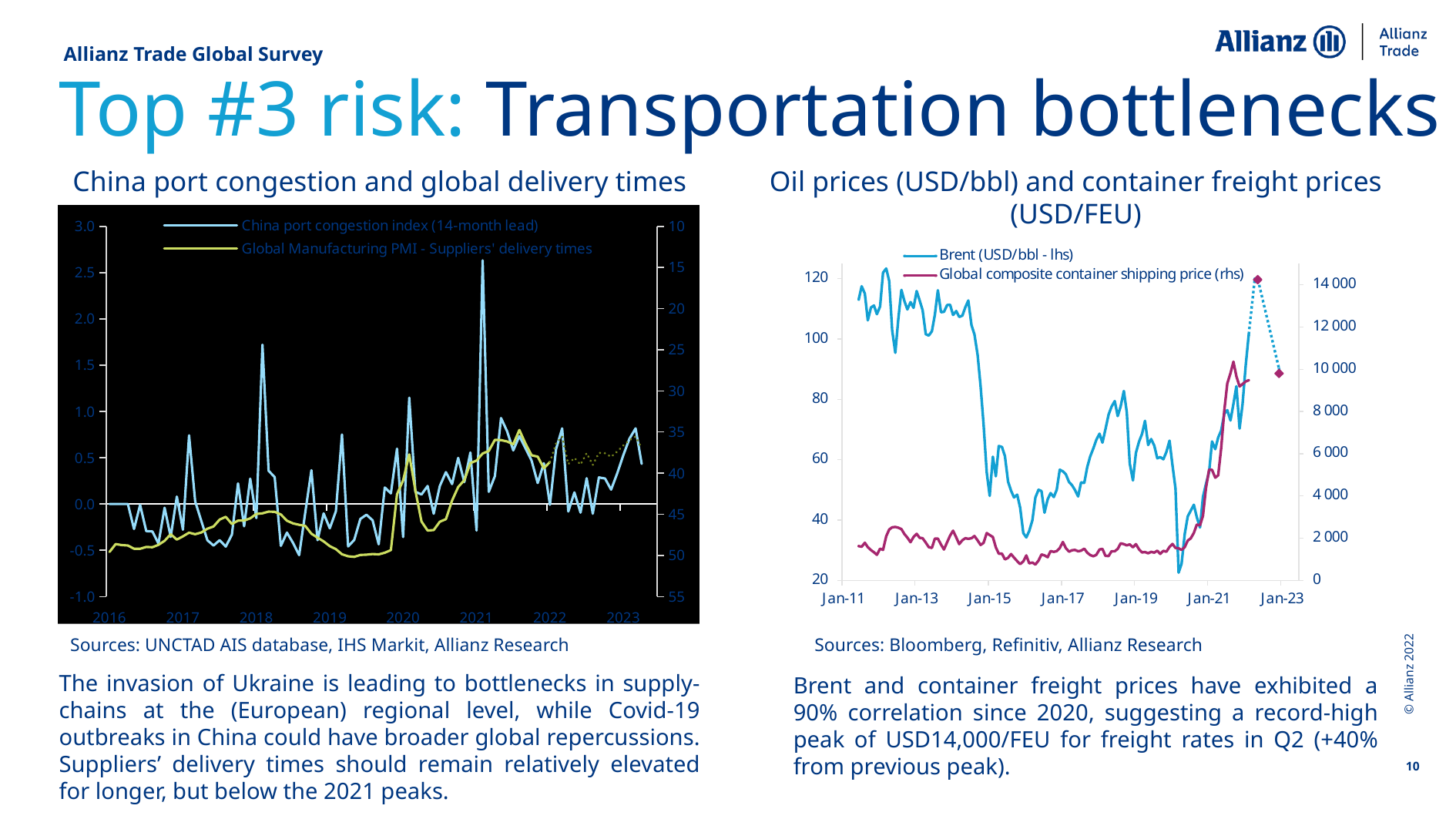
How many series does the legend of the 'Oil prices (USD/bbl) and container freight prices (USD/FEU)' chart list? 2 In the 'China port congestion and global delivery times' chart, how many year labels are shown on the x axis? 8 In the 'China port congestion and global delivery times' chart, is the peak value of the China port congestion index in 2021 greater or less than 2.0? greater What kind of chart is the 'China port congestion and global delivery times' chart? line chart In the 'Oil prices (USD/bbl) and container freight prices (USD/FEU)' chart, does the Brent price rise or fall between Jan-15 and Jan-16? fall In the 'Oil prices (USD/bbl) and container freight prices (USD/FEU)' chart, is the lowest Brent price in 2020 greater or less than 40? less How many series does the legend of the 'China port congestion and global delivery times' chart list? 2 In the 'Oil prices (USD/bbl) and container freight prices (USD/FEU)' chart, which series is plotted on the right-hand axis? Global composite container shipping price (rhs) In the 'Oil prices (USD/bbl) and container freight prices (USD/FEU)' chart, how many date labels are shown on the x axis? 7 What kind of chart is the 'Oil prices (USD/bbl) and container freight prices (USD/FEU)' chart? line chart In the 'Oil prices (USD/bbl) and container freight prices (USD/FEU)' chart, is the Brent price at Jan-11 greater or less than 100? greater In the 'China port congestion and global delivery times' chart, which series is plotted in yellow-green? Global Manufacturing PMI - Suppliers' delivery times